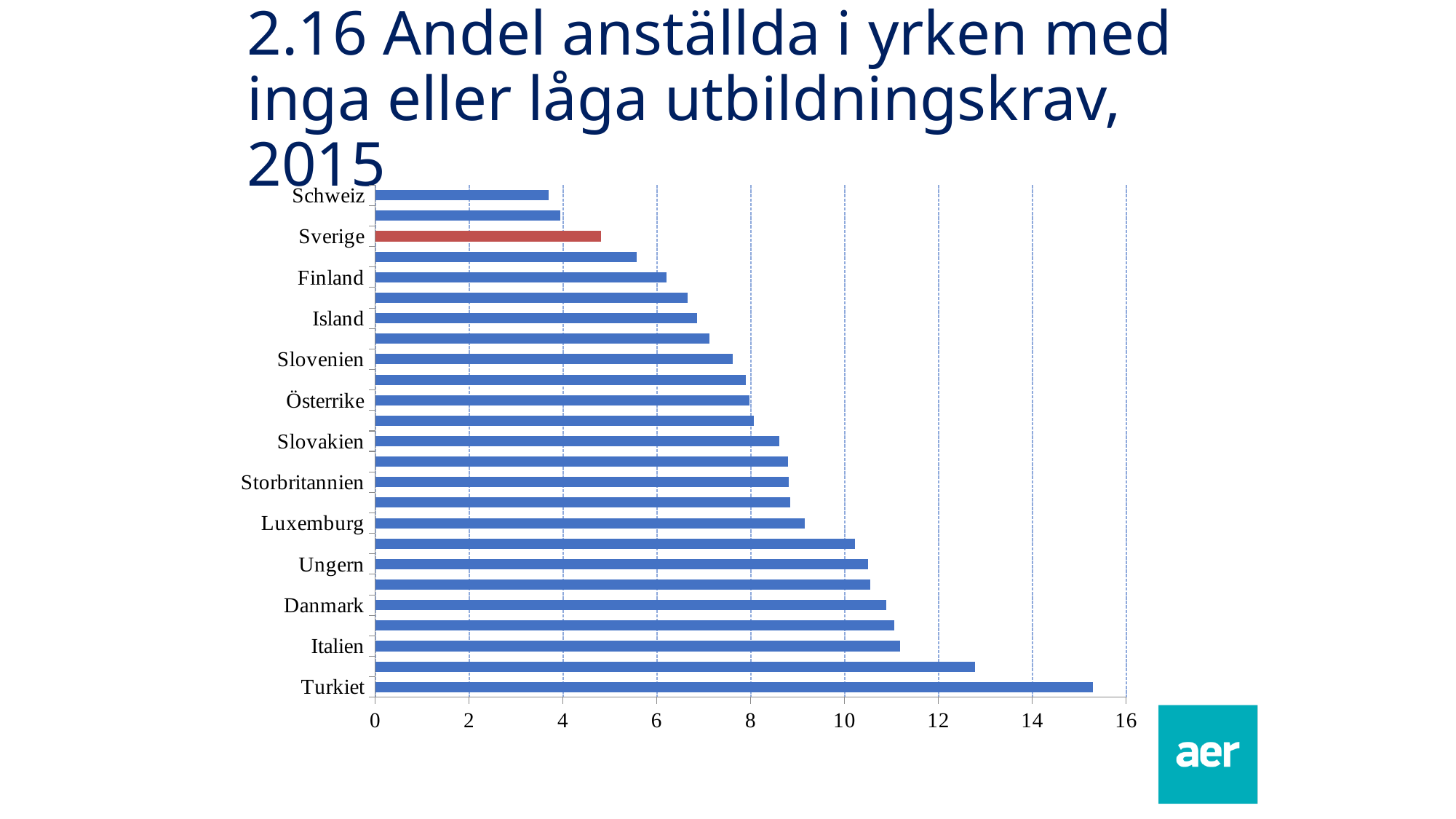
Which country has the highest value in the chart? Turkiet Is the value for Turkiet greater or less than 14? greater Which country has the lowest value in the chart? Schweiz What kind of chart is shown on the slide? bar chart Which has the larger value, Finland or Sverige? Finland Which country's bar is drawn in a different colour (red) from the others? Sverige Is the value for Schweiz greater or less than 4? less Is the value for Ungern greater or less than 10? greater Which has the larger value, Italien or Turkiet? Turkiet